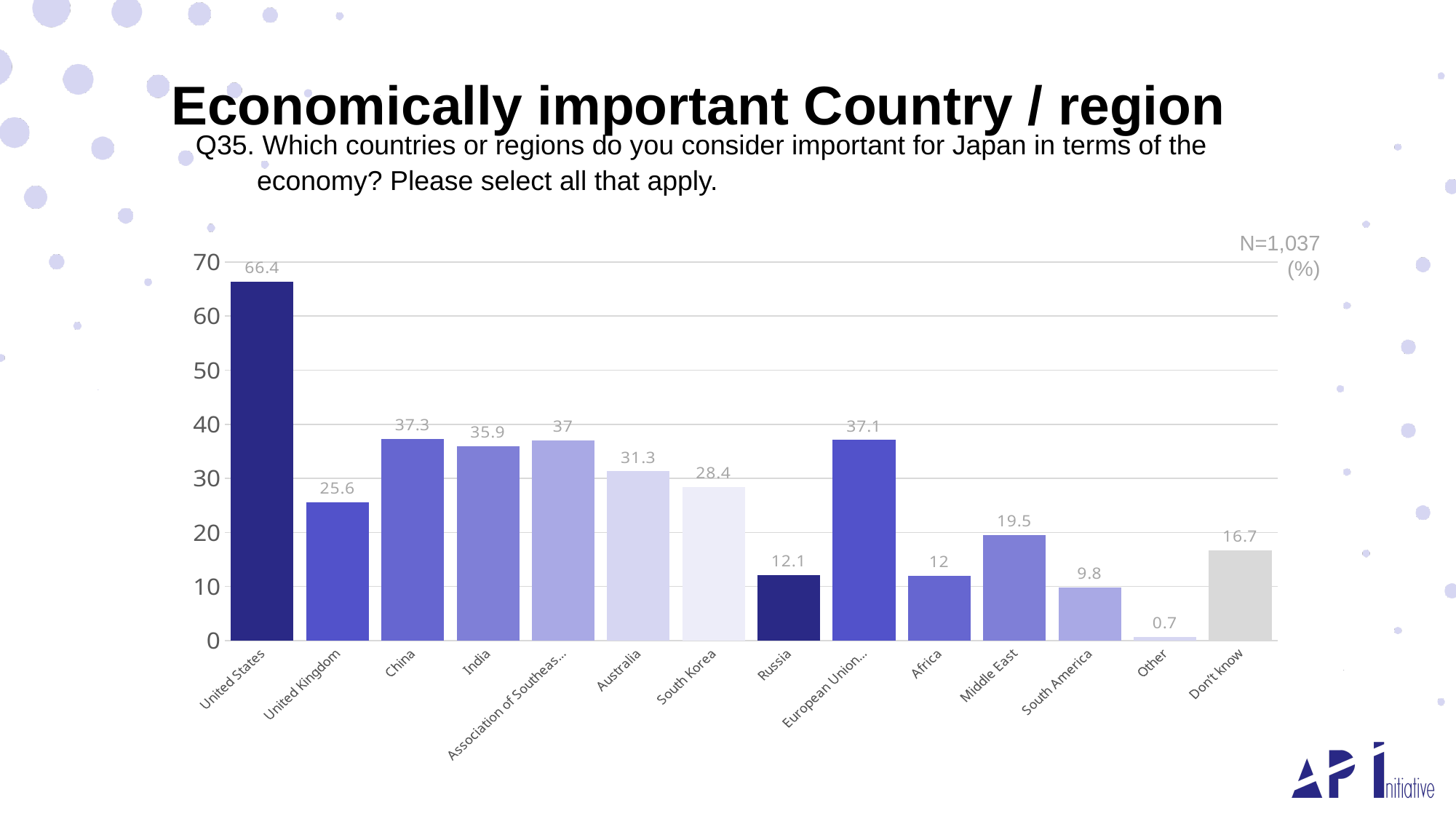
Which category has the lowest value? Other What sample size (N) is shown on the chart? N=1,037 Which category has the highest value? United States What kind of chart is shown on the slide? Bar chart Is the value for India greater or less than 30? greater What is the difference between the values for the United States and the United Kingdom? 40.8 What is the value for Don't know? 16.7 How many categories are shown on the x axis? 14 What is the value for the United States? 66.4 What is the value for China? 37.3 Which has a larger value, Australia or South Korea? Australia What is the value for Middle East? 19.5